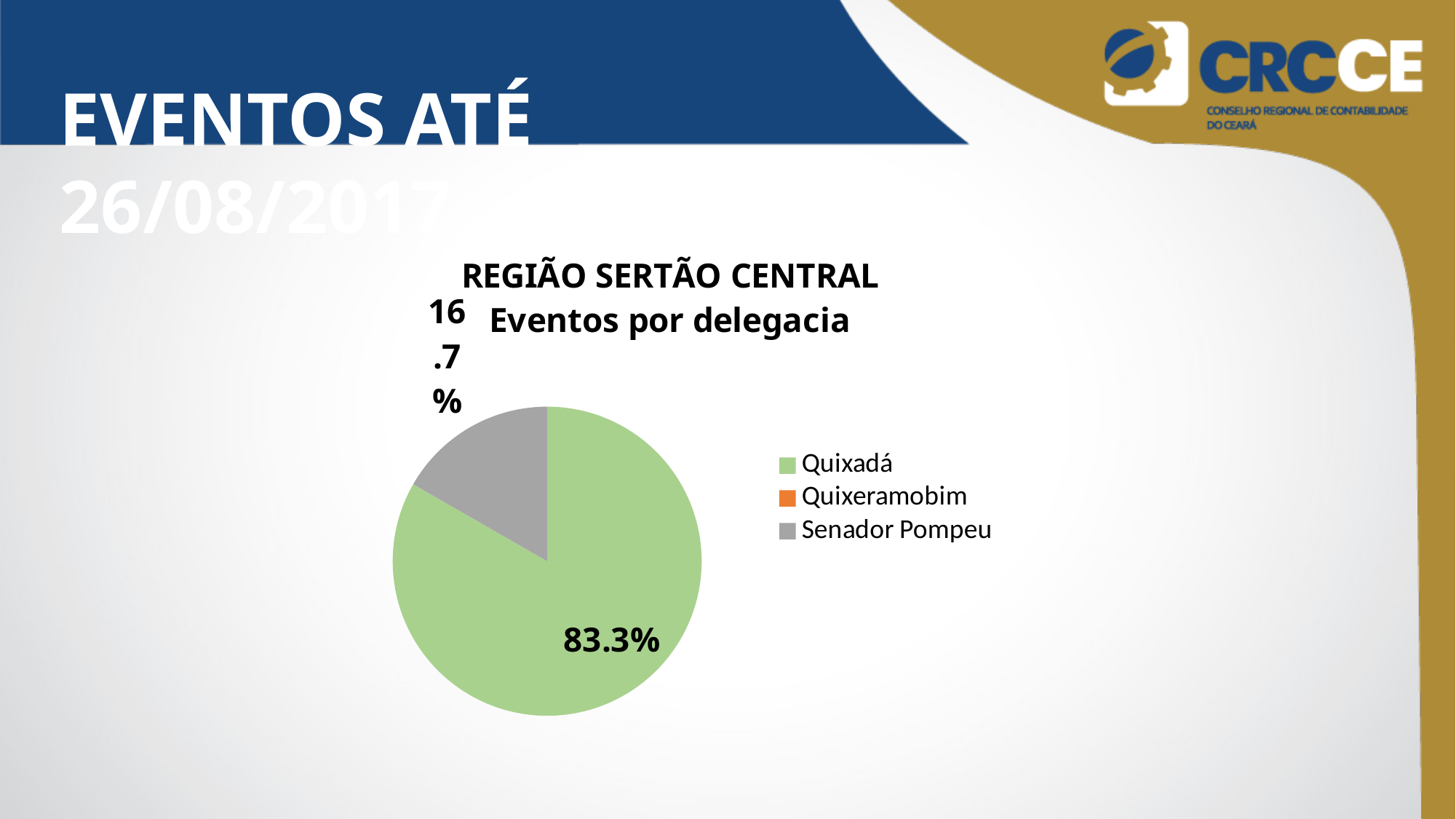
Is the share for Senador Pompeu greater or less than 25%? less What share of the pie does Quixadá account for? 83.3% Which is larger, the slice for Quixadá or the slice for Senador Pompeu? Quixadá How many delegacias are listed in the chart legend? 3 Is the share for Quixadá greater or less than 50%? greater What is the difference in percentage points between the Quixadá slice and the Senador Pompeu slice? 66.6% What is the title of the chart? REGIÃO SERTÃO CENTRAL Eventos por delegacia How many entries does the legend list? 3 What colour represents Senador Pompeu in the pie chart? gray Which delegacia has the largest slice of the pie? Quixadá What share of the pie does Senador Pompeu account for? 16.7% What kind of chart is shown on the slide? pie chart